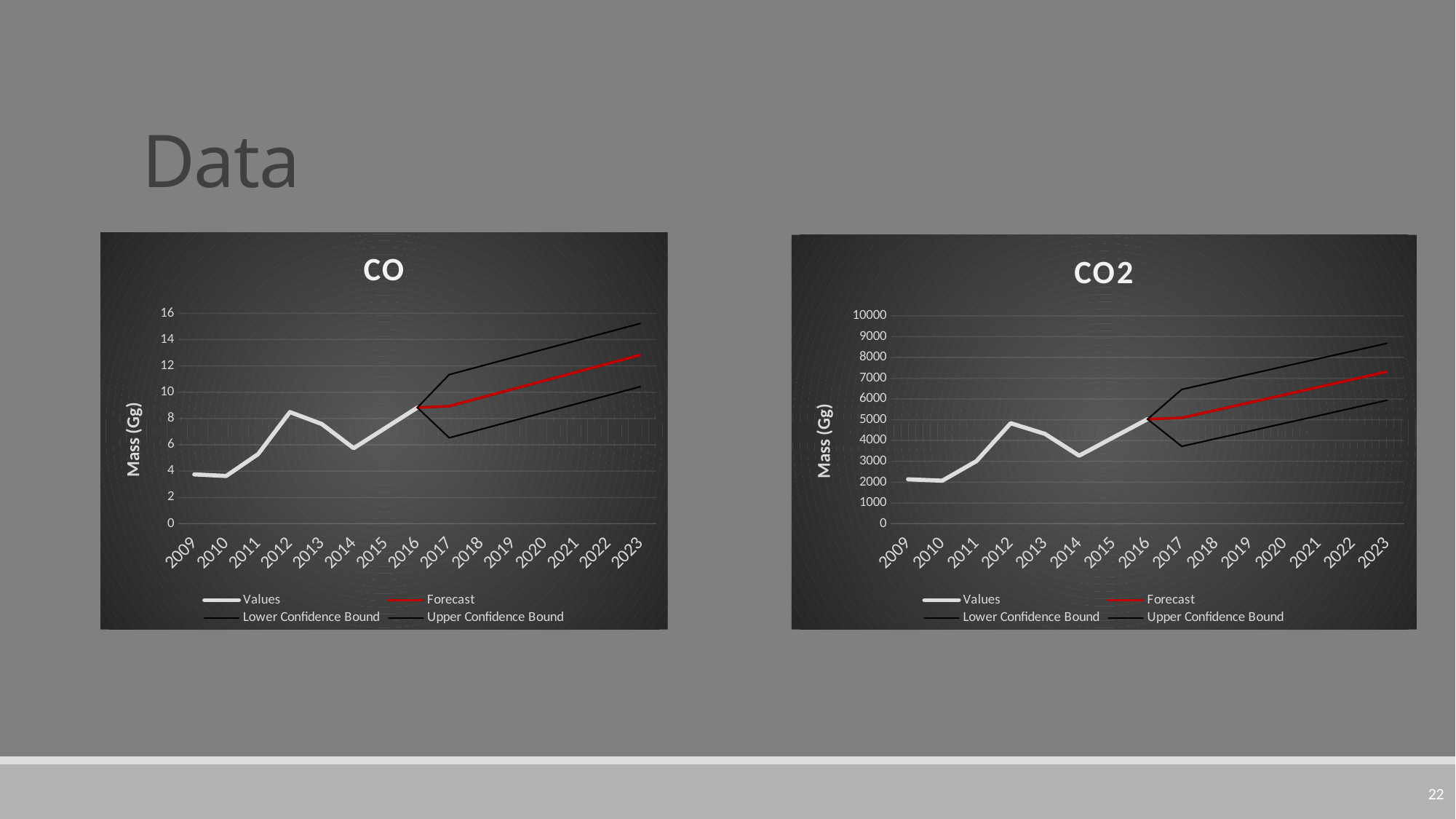
In the CO2 chart, does the Forecast series rise or fall from 2016 to 2023? rise In the CO chart, is the Values series for 2011 greater or less than 4? greater In the CO2 chart, is the Upper Confidence Bound for 2023 greater or less than 8000? greater In the CO chart, is the Values series for 2016 greater or less than 8? greater What is the y-axis label of the CO2 chart? Mass (Gg) In the CO chart, which year has the larger Values reading, 2012 or 2014? 2012 How many years are shown on the x axis of the CO chart? 15 How many series does the legend of the CO2 chart list? 4 What type of chart is the CO chart? line chart